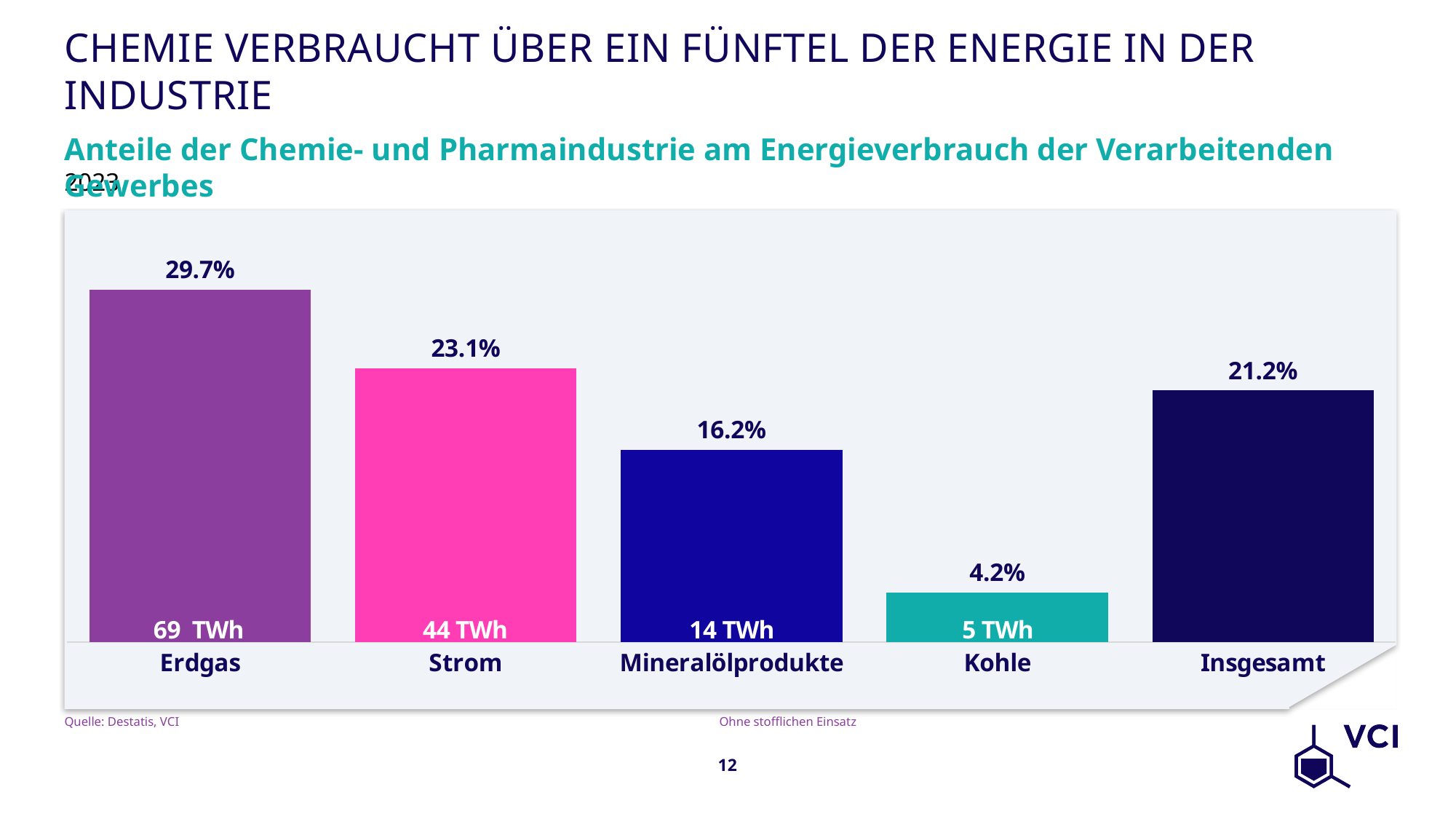
What is the difference in percentage points between Erdgas and Strom? 6.6 What is the percentage share shown for Insgesamt? 21.2% Which category has the lowest percentage share? Kohle Which has a larger percentage share, Mineralölprodukte or Insgesamt? Insgesamt What is the percentage share shown for Erdgas? 29.7% What type of chart is shown on the slide? Bar chart What is the source cited below the chart? Destatis, VCI How many bars are shown in the chart? 5 What is the percentage share shown for Strom? 23.1% How many TWh are shown inside the Mineralölprodukte bar? 14 TWh What is the percentage share shown for Kohle? 4.2% Which category has the highest percentage share? Erdgas